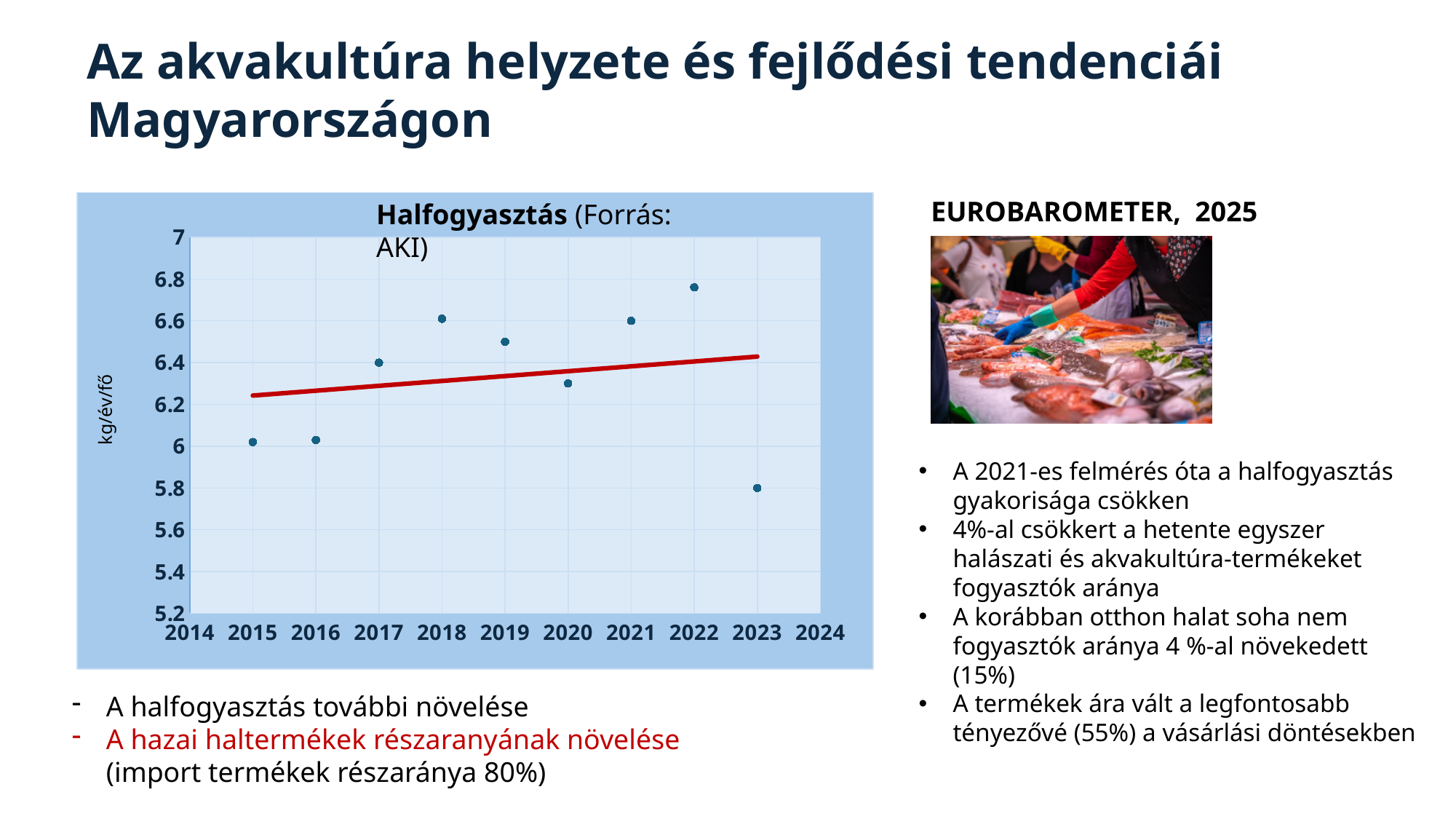
Is the value for 2022 greater or less than 6.6? greater What is the fish consumption value for 2017? 6.4 Which year has the larger value, 2018 or 2020? 2018 What unit is shown on the y axis of the chart? kg/év/fő Which year has the highest fish consumption value in the chart? 2022 How many data points are plotted in the chart? 9 What is the difference between the values for 2021 and 2023? 0.8 What is the fish consumption value for 2023? 5.8 What is the title of the chart? Halfogyasztás (Forrás: AKI) What kind of chart is shown on the slide? scatter chart Which year has the lowest fish consumption value in the chart? 2023 Does the red trend line rise or fall from 2015 to 2023? rises